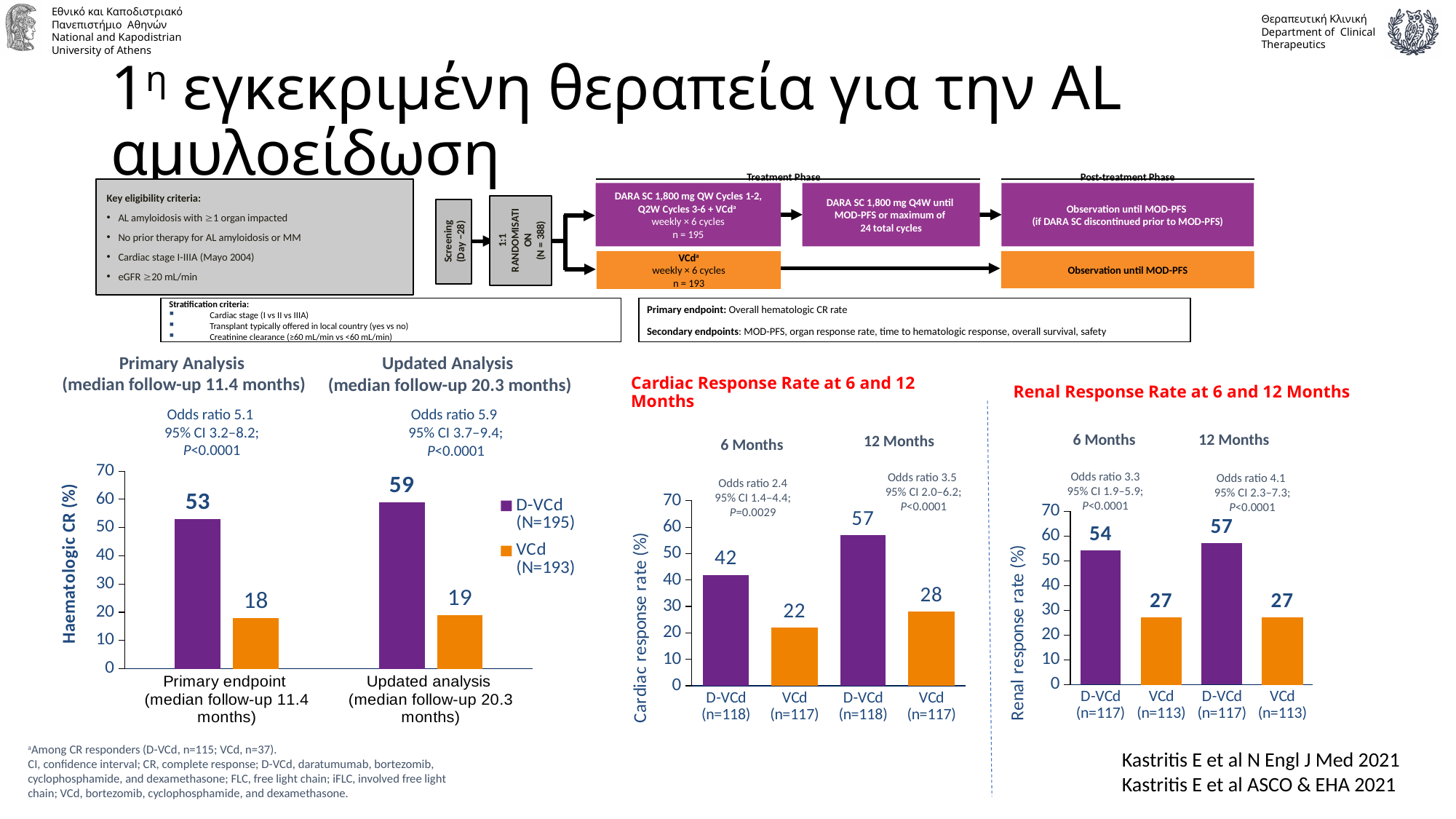
What kind of chart is the Renal Response Rate at 6 and 12 Months chart? Bar chart In the Haematologic CR chart on the left, how many series does the legend list? 2 In the Cardiac Response Rate at 6 and 12 Months chart, what is the value for D-VCd at 6 months? 42 In the Renal Response Rate at 6 and 12 Months chart, which is larger, D-VCd at 6 months or VCd at 6 months? D-VCd at 6 months In the Cardiac Response Rate at 6 and 12 Months chart, how many bars are plotted? 4 In the Haematologic CR chart on the left, what is the value for VCd in the updated analysis (median follow-up 20.3 months)? 19 In the Haematologic CR chart on the left, which series is shown in purple? D-VCd (N=195) In the Renal Response Rate at 6 and 12 Months chart, what is the value for D-VCd at 12 months? 57 In the Cardiac Response Rate at 6 and 12 Months chart, which bar is the lowest? VCd at 6 months In the Cardiac Response Rate at 6 and 12 Months chart, what is the difference between D-VCd and VCd at 12 months? 29 In the Haematologic CR chart on the left, what is the difference between D-VCd and VCd in the updated analysis? 40 In the Haematologic CR chart on the left, what is the value for D-VCd at the primary endpoint (median follow-up 11.4 months)? 53